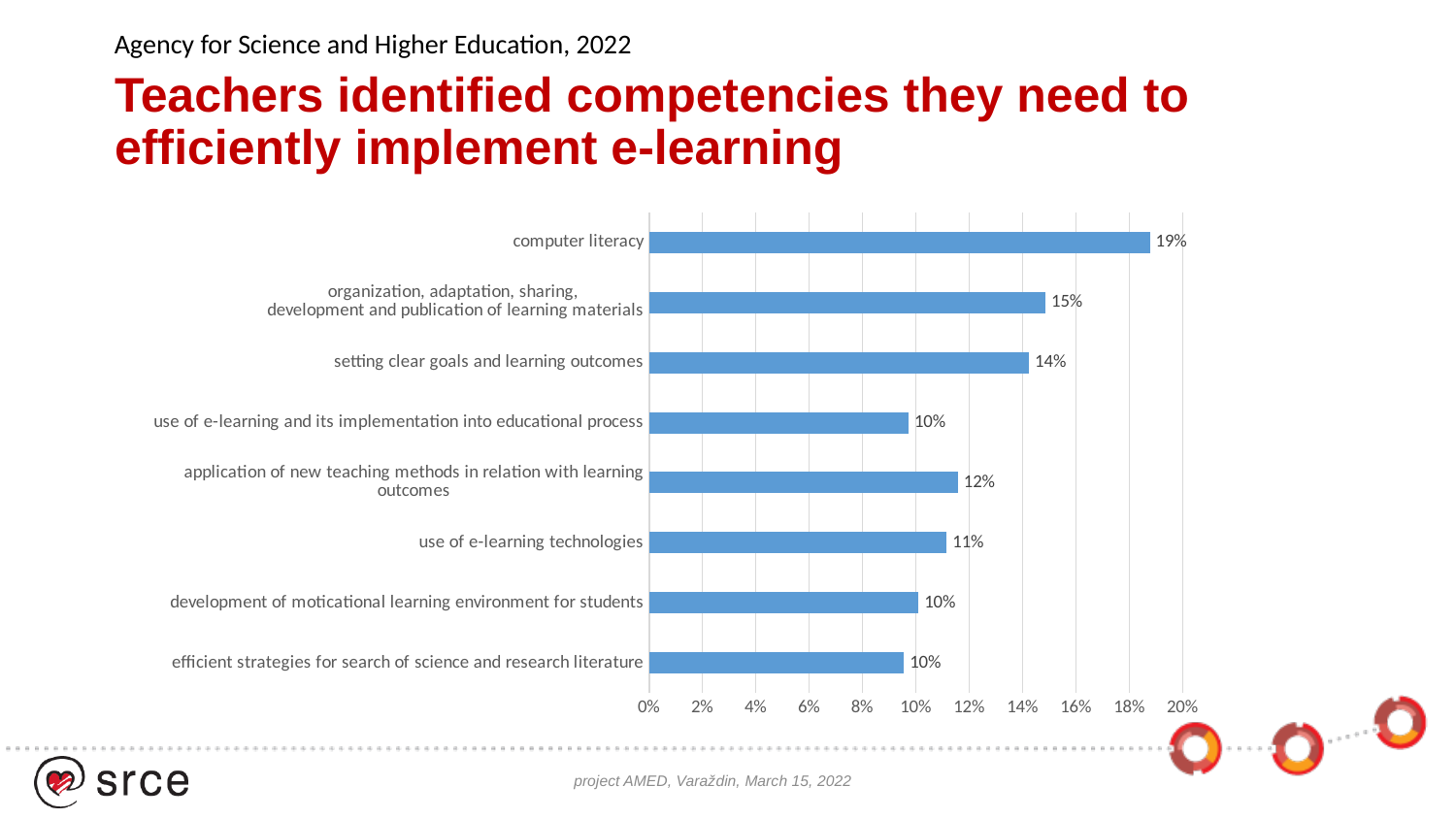
What is the value for application of new teaching methods in relation with learning outcomes? 12% What is the value for setting clear goals and learning outcomes? 14% Which is larger: the value for setting clear goals and learning outcomes or the value for use of e-learning technologies? setting clear goals and learning outcomes What is the value for computer literacy? 19% Is the value for computer literacy greater or less than 16%? greater What is the title of the slide containing the chart? Teachers identified competencies they need to efficiently implement e-learning What kind of chart is shown on the slide? bar chart What is the difference between the value for computer literacy and the value for organization, adaptation, sharing, development and publication of learning materials? 4% How many competencies (categories) are plotted in the chart? 8 What is the value for use of e-learning technologies? 11% Which competency has the highest value? computer literacy What is the value for organization, adaptation, sharing, development and publication of learning materials? 15%